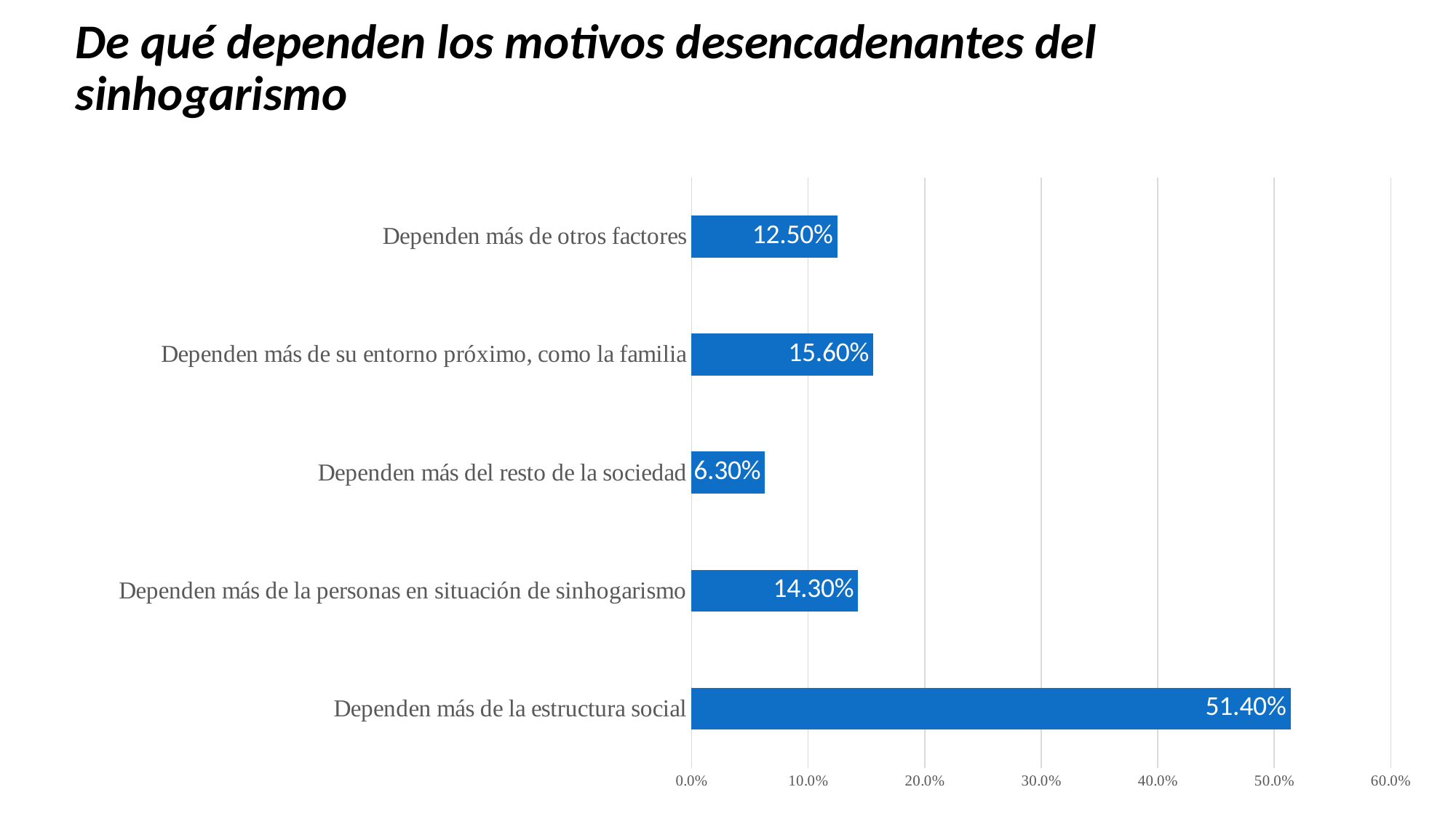
What is the difference between the values for "Dependen más de la estructura social" and "Dependen más de su entorno próximo, como la familia"? 35.80% Which is larger: the value for "Dependen más de la personas en situación de sinhogarismo" or the value for "Dependen más de otros factores"? Dependen más de la personas en situación de sinhogarismo What is the value for "Dependen más de otros factores"? 12.50% Which category has the lowest value? Dependen más del resto de la sociedad Is the value for "Dependen más de la estructura social" greater or less than 50.0%? greater How many categories are shown in the chart? 5 What is the title of the slide? De qué dependen los motivos desencadenantes del sinhogarismo What is the value for "Dependen más de su entorno próximo, como la familia"? 15.60% What is the value for "Dependen más del resto de la sociedad"? 6.30% Which category has the highest value? Dependen más de la estructura social What kind of chart is shown on the slide? Bar chart What is the value for "Dependen más de la estructura social"? 51.40%